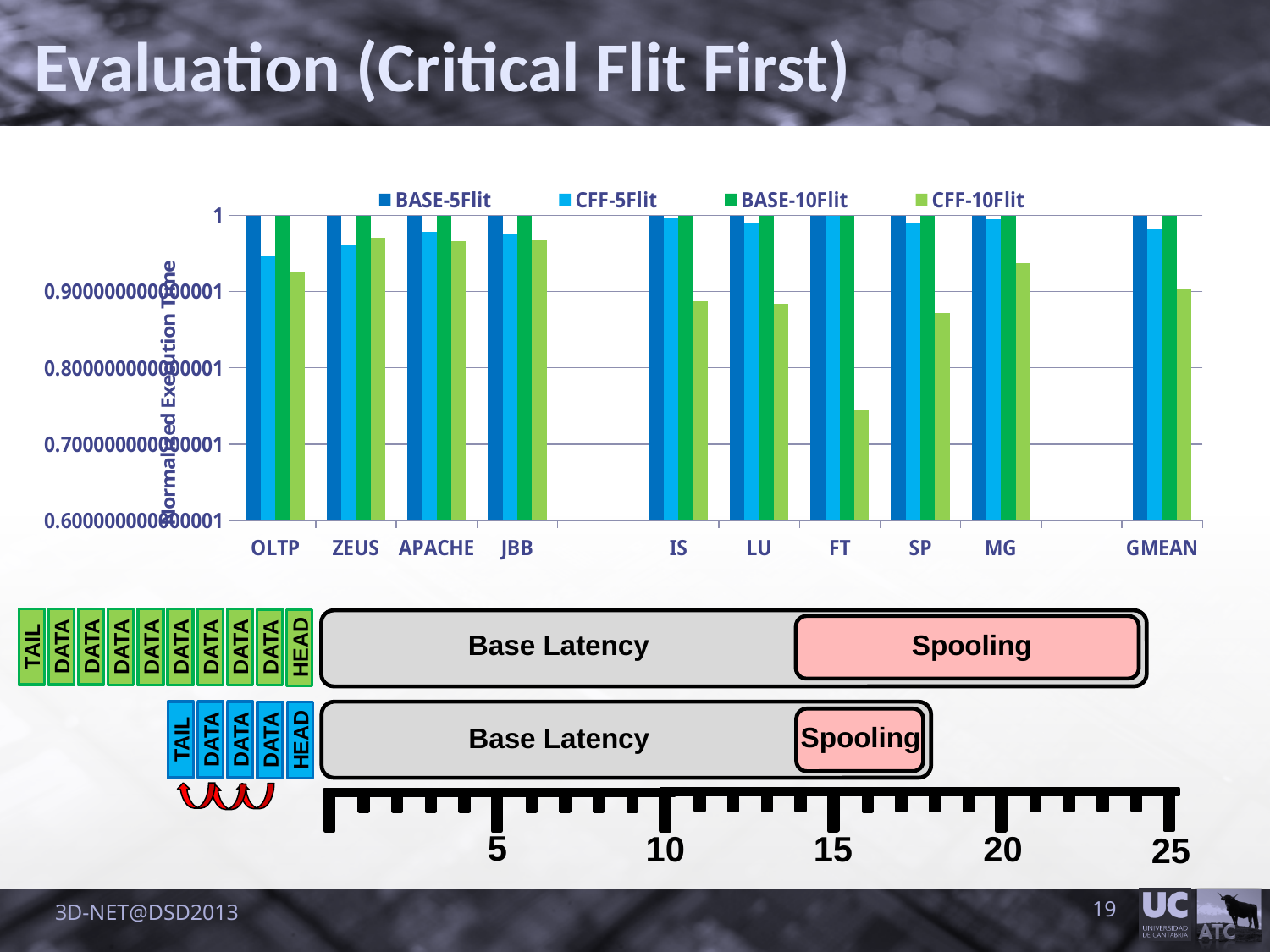
Is the CFF-10Flit value for OLTP greater or less than 0.9? greater Is the CFF-10Flit value for FT greater or less than 0.8? less Which is larger, the CFF-10Flit value for FT or the CFF-10Flit value for MG? MG How many series does the legend of the bar chart list? 4 How many categories are shown along the x axis of the bar chart? 10 What is the title of the y axis of the bar chart? Normalized Execution Time Which category has the lowest CFF-10Flit value in the bar chart? FT For the FT category, which series has the lowest bar? CFF-10Flit What are the four series listed in the legend of the bar chart? BASE-5Flit, CFF-5Flit, BASE-10Flit, CFF-10Flit What kind of chart is shown on the slide? bar chart Is the CFF-10Flit value for IS greater or less than 0.9? less